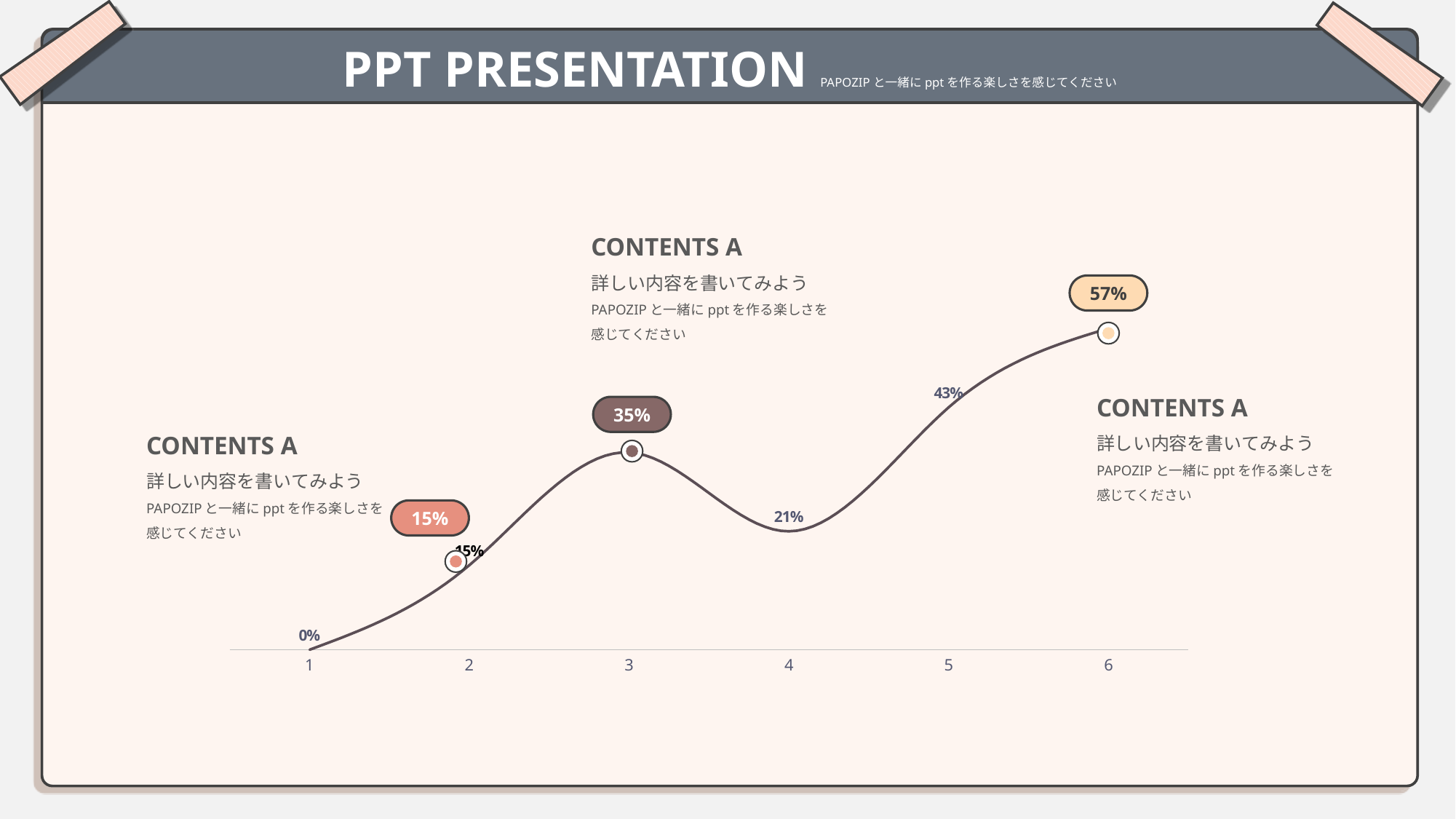
Does the value rise or fall from category 3 to category 4? fall What is the value at category 1 on the line chart? 0% What is the value at category 4 on the line chart? 21% How many categories are shown on the x axis of the chart? 6 What kind of chart is shown on the slide? line chart What is the difference between the values at category 3 and category 2? 20% What is the value at category 5 on the line chart? 43% Which category has the lowest value on the line chart? 1 Which category has the highest value on the line chart? 6 What is the value at category 6 on the line chart? 57% What is the difference between the values at category 6 and category 5? 14% Which has the larger value, category 3 or category 4? 3